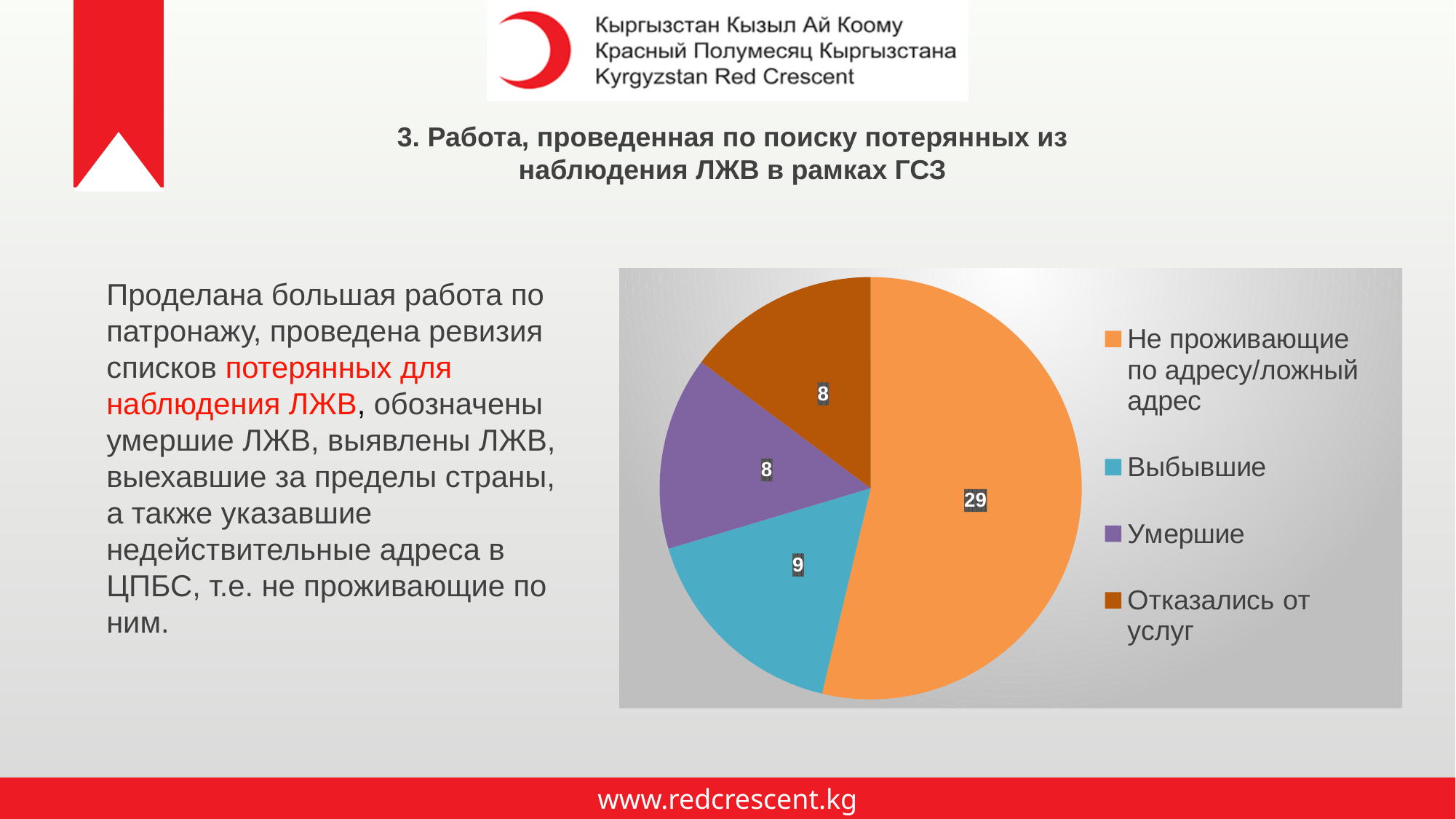
What is the value for "Не проживающие по адресу/ложный адрес" in the pie chart? 29 Which category has the largest slice in the pie chart? Не проживающие по адресу/ложный адрес How many slices does the pie chart have? 4 What is the value for "Отказались от услуг" in the pie chart? 8 Which two categories share the smallest value in the pie chart? Умершие and Отказались от услуг What is the value for "Выбывшие" in the pie chart? 9 What is the total of all the values shown in the pie chart? 54 Which is larger: the value for "Выбывшие" or the value for "Умершие"? Выбывшие What is the difference between the values for "Не проживающие по адресу/ложный адрес" and "Выбывшие"? 20 What colour is the slice for "Отказались от услуг" in the pie chart? Brown What is the value for "Умершие" in the pie chart? 8 What type of chart is shown on the slide? Pie chart